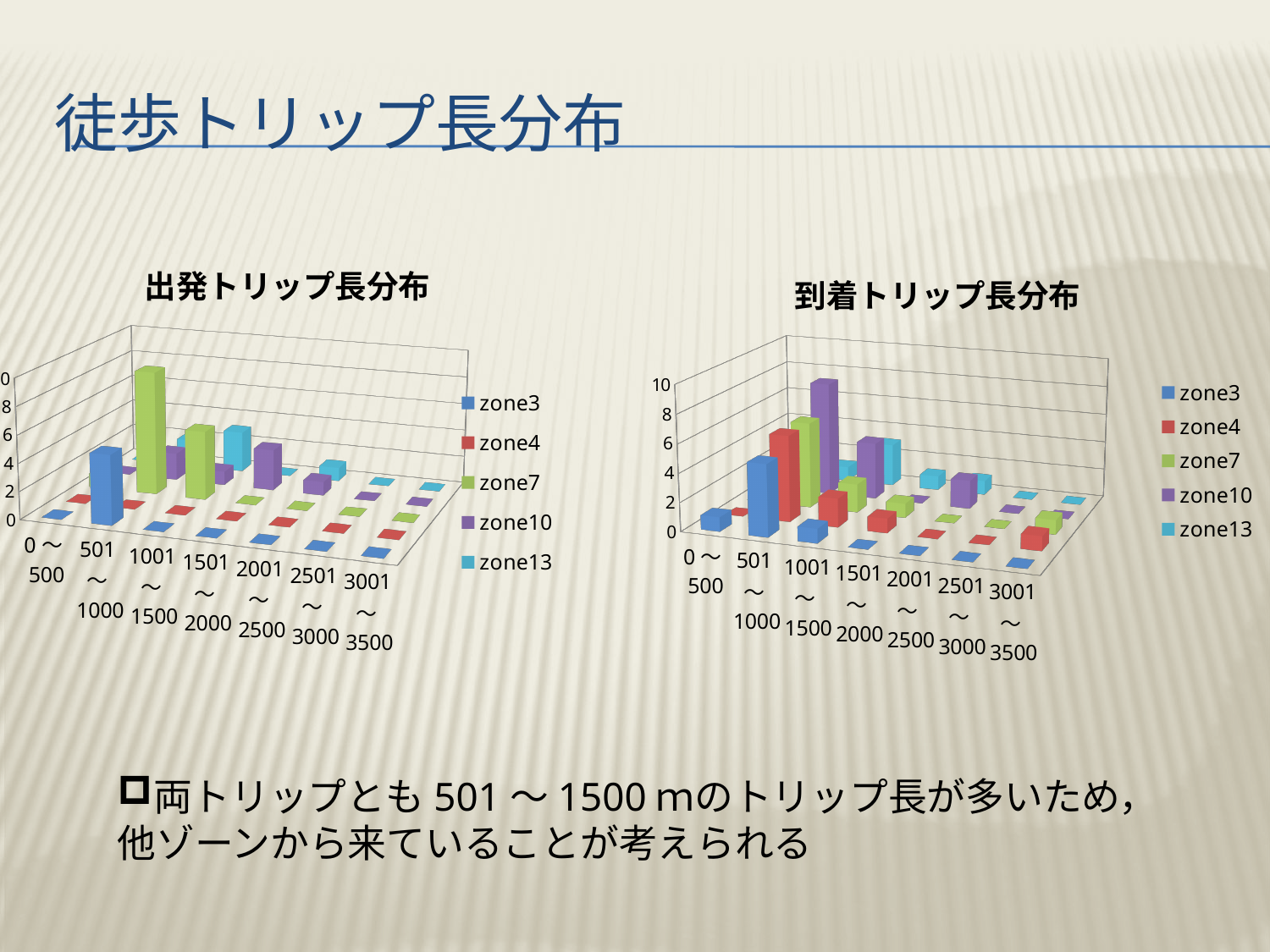
In the left chart (出発トリップ長分布), how many series does the legend list? 5 What type of chart is the right chart titled 到着トリップ長分布? bar chart In the right chart (到着トリップ長分布), how many series does the legend list? 5 In the left chart (出発トリップ長分布), is the value for zone7 at 501～1000 greater or less than 6? greater What is the title of the right chart? 到着トリップ長分布 In the left chart (出発トリップ長分布), how many trip-length categories are shown on the x axis? 7 In the right chart (到着トリップ長分布), in which trip-length category is the zone10 bar highest? 501～1000 In the right chart (到着トリップ長分布), which series is shown in purple according to the legend? zone10 In the right chart (到着トリップ長分布), is the value for zone3 at 0～500 greater or less than 4? less In the left chart (出発トリップ長分布), in which trip-length category is the zone7 bar highest? 501～1000 What type of chart is the left chart titled 出発トリップ長分布? bar chart